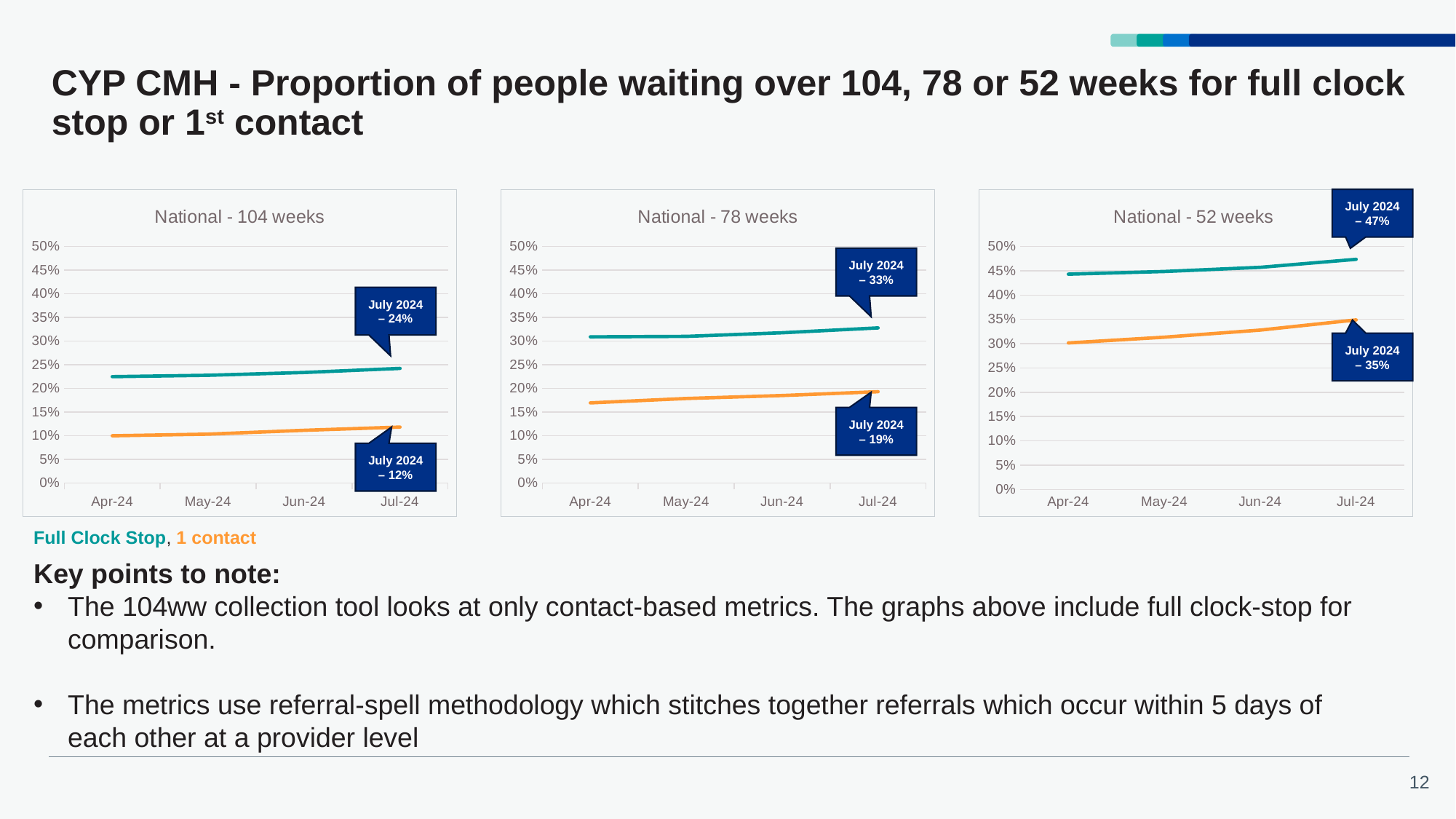
In the 'National - 104 weeks' chart, is the Full Clock Stop value for Apr-24 greater or less than 20%? greater In the 'National - 78 weeks' chart, which series has the higher value in July 2024, Full Clock Stop or 1 contact? Full Clock Stop In the 'National - 104 weeks' chart, what is the Full Clock Stop value for July 2024? 24% In the 'National - 52 weeks' chart, what is the 1 contact value for July 2024? 35% In the 'National - 52 weeks' chart, what is the difference between the Full Clock Stop and 1 contact values for July 2024? 12% In the 'National - 78 weeks' chart, what is the 1 contact value for July 2024? 19% In the 'National - 104 weeks' chart, what is the 1 contact value for July 2024? 12% In the 'National - 52 weeks' chart, what is the Full Clock Stop value for July 2024? 47% How many months are shown on the x axis of the 'National - 52 weeks' chart? 4 What kind of chart is the 'National - 78 weeks' chart? Line chart In the 'National - 78 weeks' chart, what is the Full Clock Stop value for July 2024? 33% In the 'National - 52 weeks' chart, does the 1 contact line rise or fall from Apr-24 to Jul-24? Rise